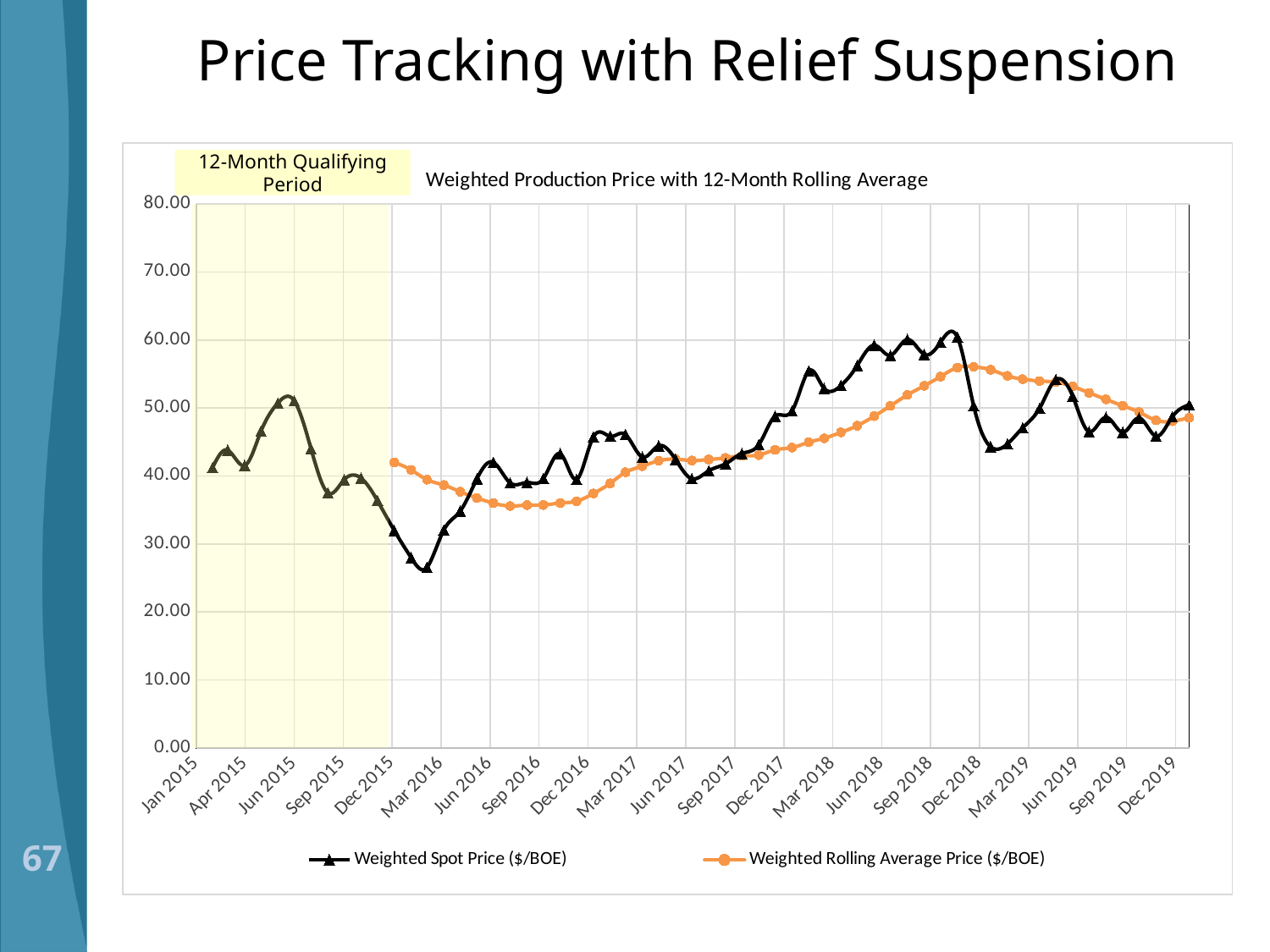
What kind of chart is shown on the slide? line chart Is the lowest value of the Weighted Rolling Average Price ($/BOE) series greater or less than 40? less Does the Weighted Spot Price rise or fall between Jan 2015 and Jun 2015? rise Does the Weighted Rolling Average Price rise or fall between Sep 2016 and Sep 2018? rise Which series reaches the higher peak value, Weighted Spot Price or Weighted Rolling Average Price? Weighted Spot Price ($/BOE) At Mar 2016, which series has the larger value, Weighted Spot Price or Weighted Rolling Average Price? Weighted Rolling Average Price ($/BOE) What is the title of the chart? Weighted Production Price with 12-Month Rolling Average How many series does the legend list? 2 What label is shown on the shaded region at the left of the chart? 12-Month Qualifying Period Is the highest value of the Weighted Spot Price ($/BOE) series greater or less than 55? greater Is the lowest value of the Weighted Spot Price ($/BOE) series greater or less than 30? less